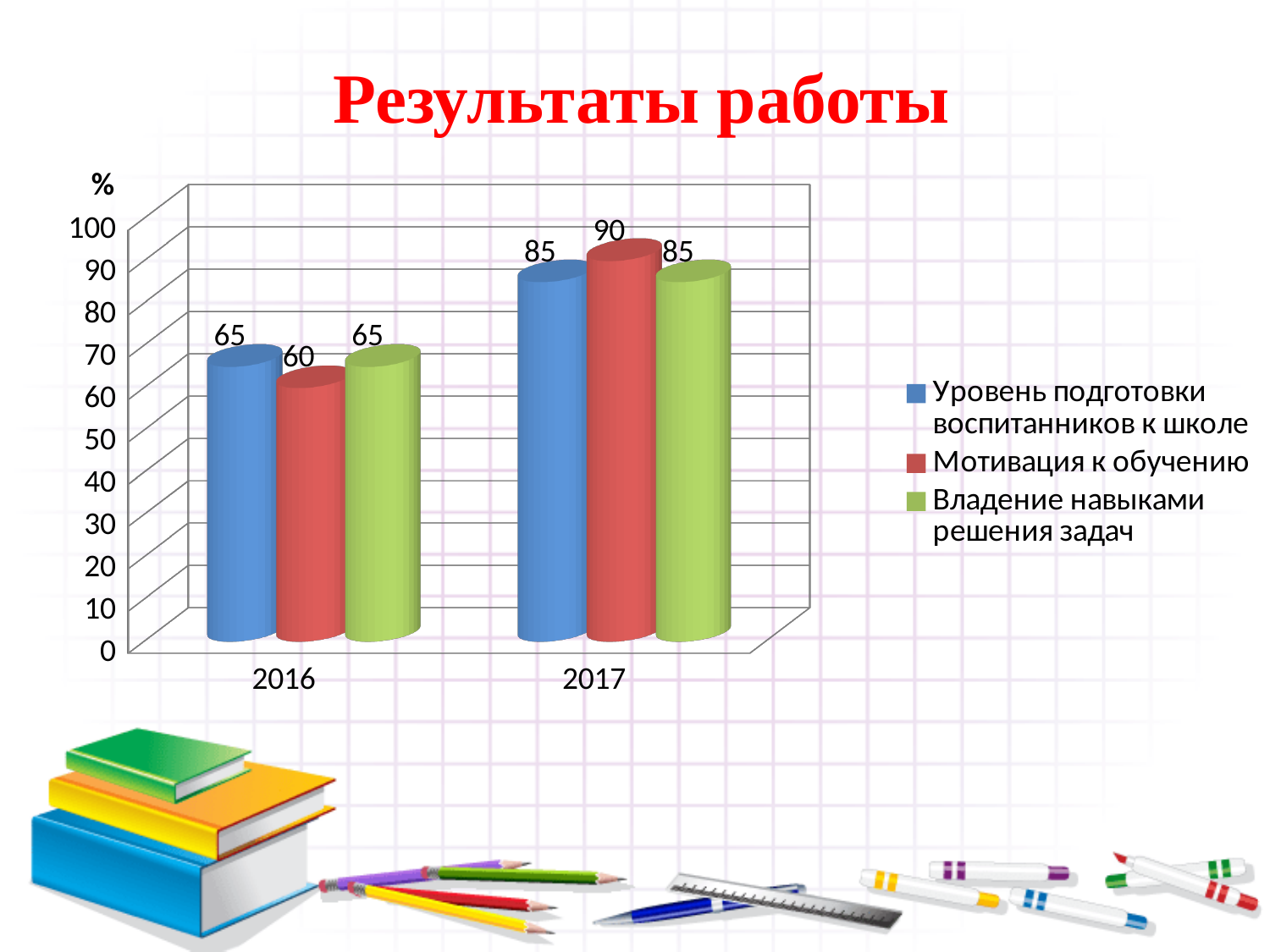
What kind of chart is shown on the slide? bar chart What is the value for "Уровень подготовки воспитанников к школе" in 2017? 85 What is the value for "Мотивация к обучению" in 2016? 60 Which series has the highest value in 2017? Мотивация к обучению Which series has the lowest value in 2016? Мотивация к обучению Is the 2017 value for "Владение навыками решения задач" greater or less than 80? greater Which is larger: the 2016 value for "Уровень подготовки воспитанников к школе" or the 2016 value for "Мотивация к обучению"? Уровень подготовки воспитанников к школе How many series does the legend list? 3 What is the value for "Владение навыками решения задач" in 2016? 65 What is the difference between the 2017 and 2016 values for "Мотивация к обучению"? 30 Do the values for "Уровень подготовки воспитанников к школе" rise or fall from 2016 to 2017? rise How many years are shown on the x axis? 2